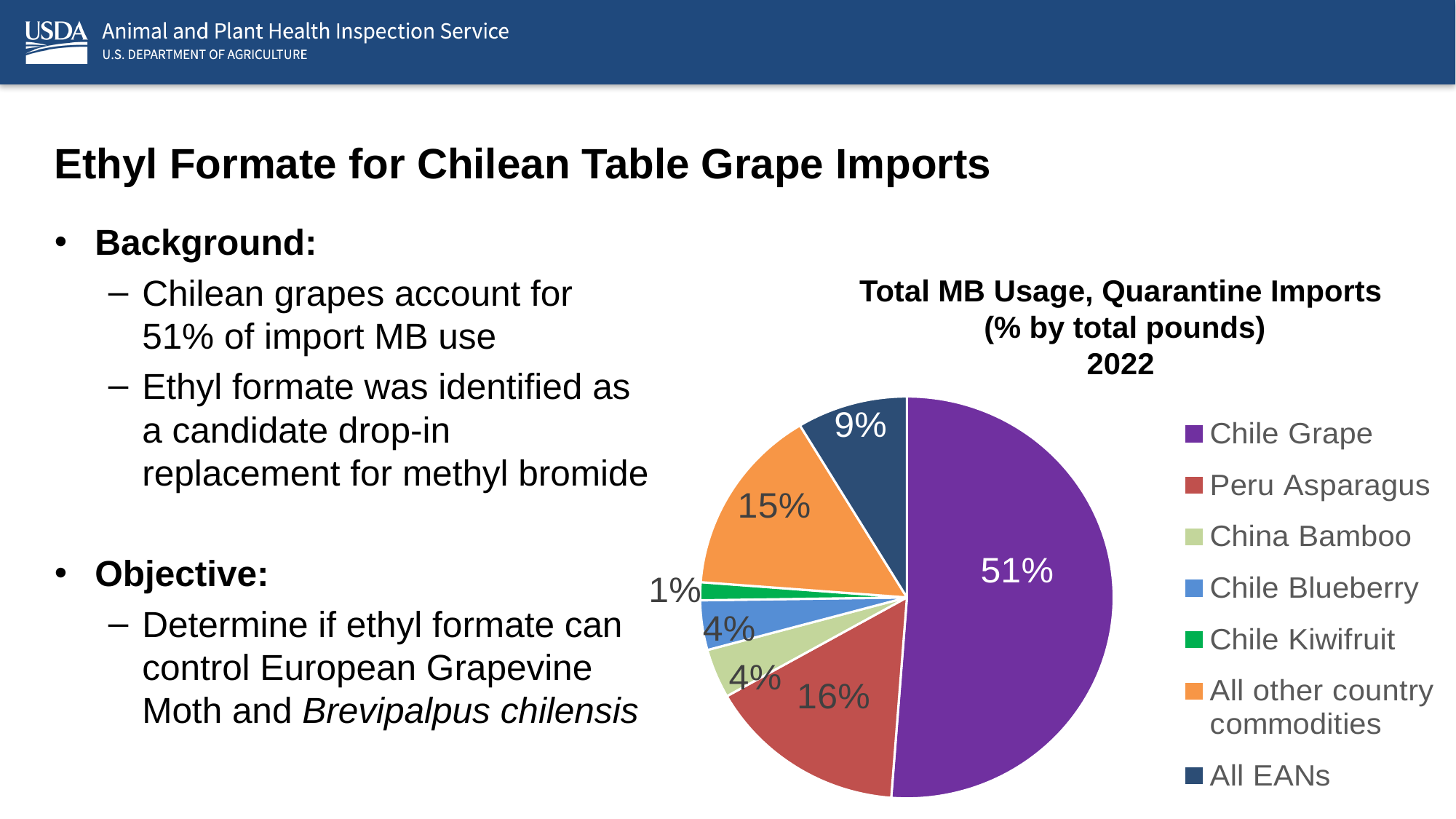
What percentage is shown for Chile Kiwifruit? 1% What is the difference in percentage points between Chile Grape and Peru Asparagus? 35 What share of the pie does Chile Grape account for? 51% What type of chart is shown on the slide? Pie chart What percentage is shown for All EANs? 9% Which category has the largest slice of the pie? Chile Grape What percentage is shown for All other country commodities? 15% How many categories does the pie chart show? 7 Which is larger, the share for All other country commodities or the share for All EANs? All other country commodities Which category has the smallest slice of the pie? Chile Kiwifruit What is the title of the chart? Total MB Usage, Quarantine Imports (% by total pounds) 2022 What percentage is shown for Peru Asparagus? 16%